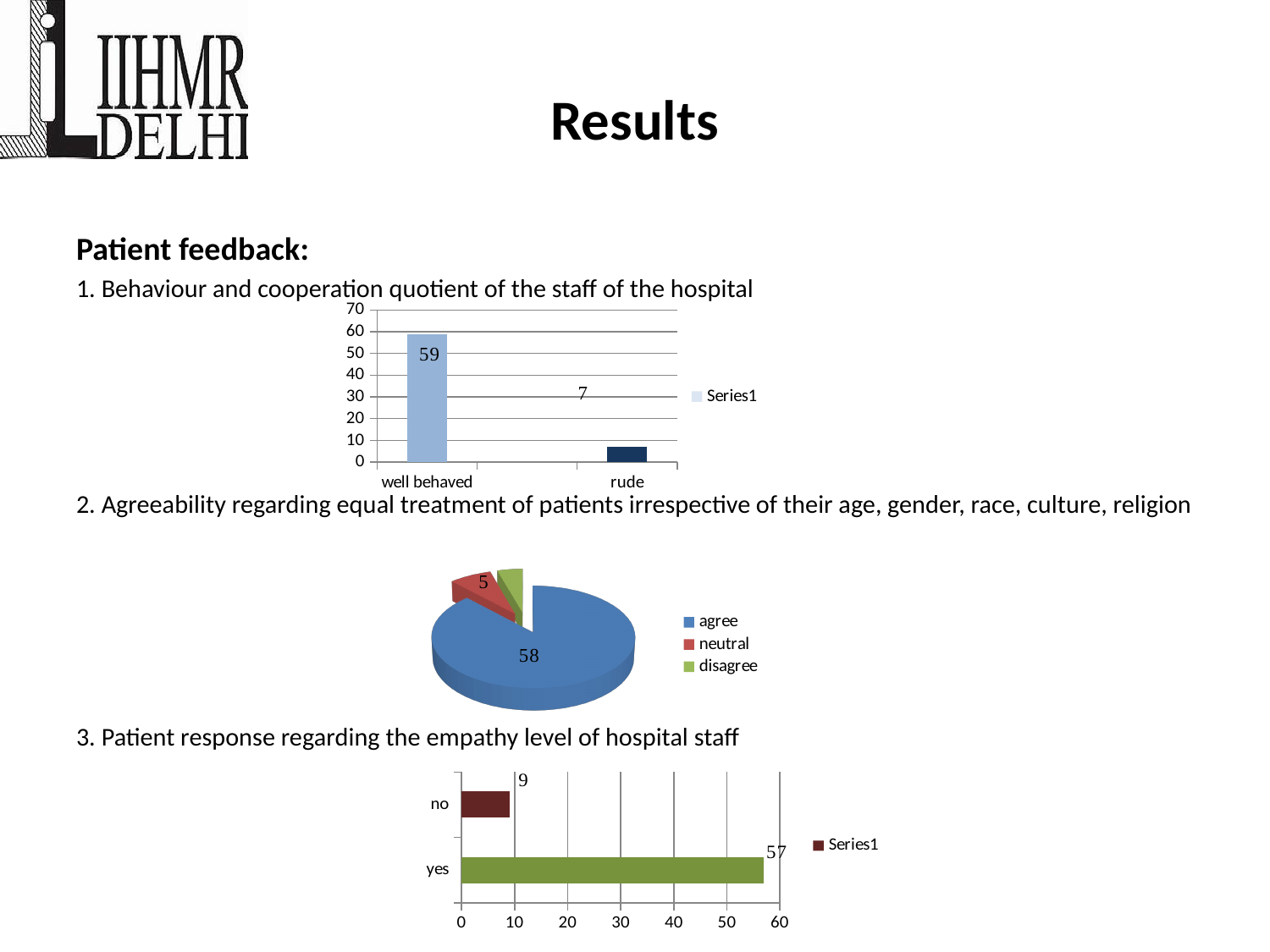
In the first chart (behaviour and cooperation quotient of the staff), what is the value for 'well behaved'? 59 In the third chart (patient response regarding the empathy level of hospital staff), what is the value for 'no'? 9 In the third chart (patient response regarding the empathy level of hospital staff), what is the value for 'yes'? 57 In the second chart (agreeability regarding equal treatment of patients), which category has the largest slice? agree In the second chart (agreeability regarding equal treatment of patients), what is the value for 'agree'? 58 In the first chart (behaviour and cooperation quotient of the staff), how many categories are shown on the x axis? 2 In the first chart (behaviour and cooperation quotient of the staff), what is the value for 'rude'? 7 In the third chart (patient response regarding the empathy level of hospital staff), which is larger, the value for 'yes' or the value for 'no'? yes In the first chart (behaviour and cooperation quotient of the staff), what kind of chart is shown? Bar chart In the second chart (agreeability regarding equal treatment of patients), what is the value for 'neutral'? 5 In the first chart (behaviour and cooperation quotient of the staff), what is the difference between the 'well behaved' and 'rude' values? 52 In the second chart (agreeability regarding equal treatment of patients), how many entries does the legend list? 3